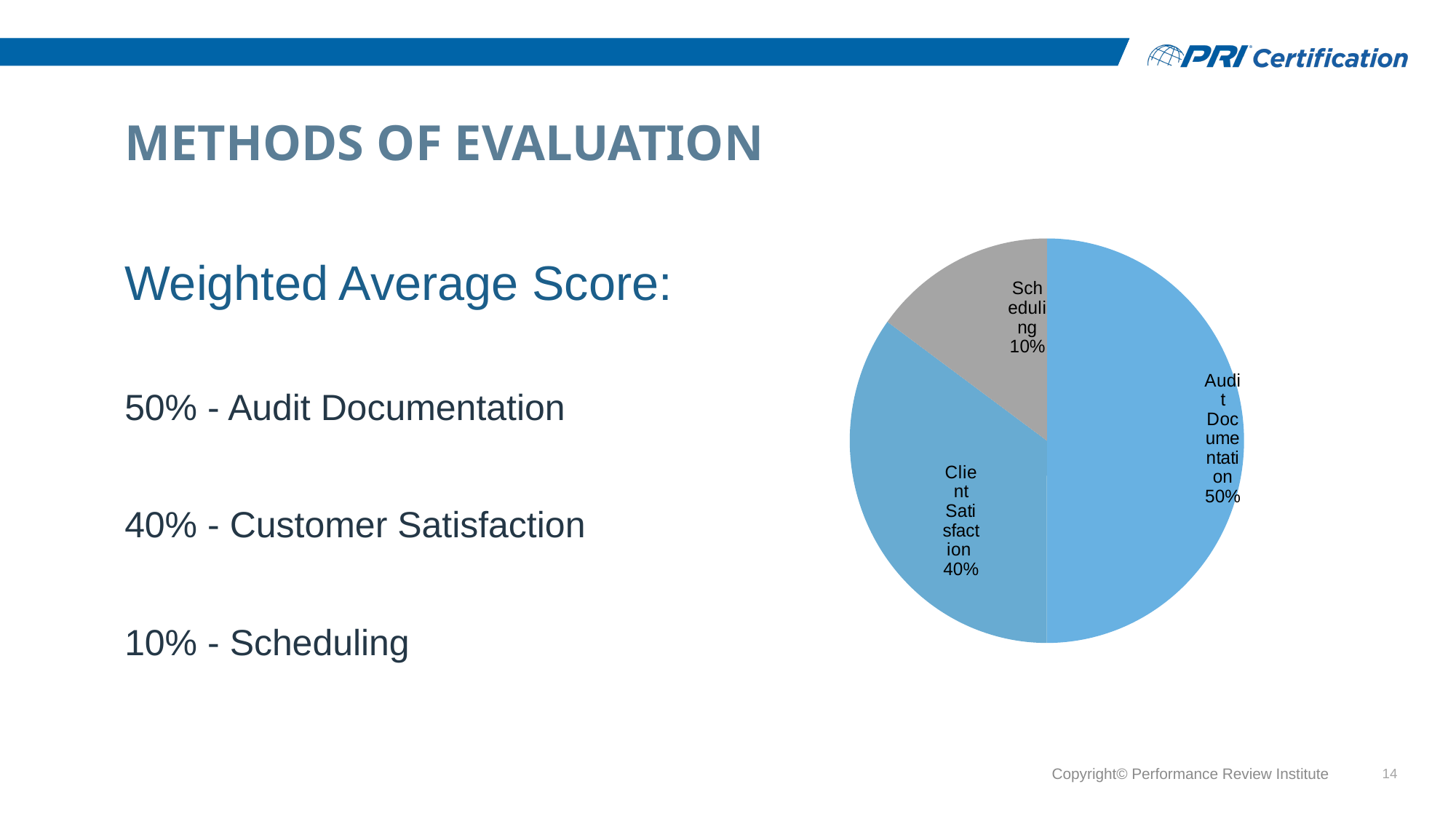
What colour is the Scheduling slice of the pie? grey What share of the pie does Client Satisfaction have? 40% What is the title of the slide containing the pie chart? METHODS OF EVALUATION Which slice of the pie is the smallest? Scheduling What is the difference between the Audit Documentation share and the Client Satisfaction share? 10% What is the difference between the Client Satisfaction share and the Scheduling share? 30% What share of the pie does Scheduling have? 10% Which is larger, the Client Satisfaction slice or the Scheduling slice? Client Satisfaction How many slices does the pie chart have? 3 Which slice of the pie is the largest? Audit Documentation What kind of chart is shown on the slide? pie chart What share of the pie does Audit Documentation have? 50%